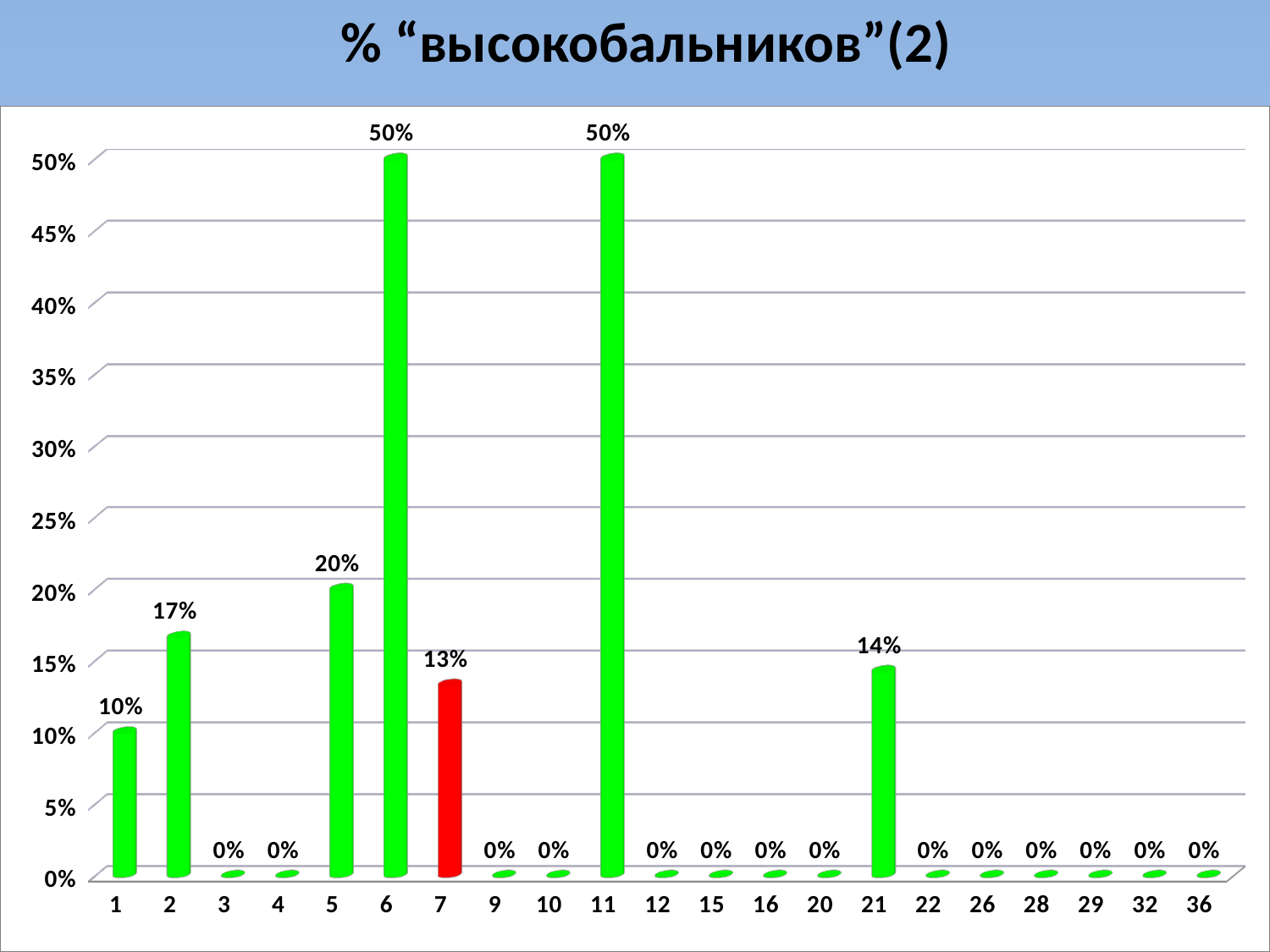
Which category's bar is coloured red instead of green? 7 What is the value for category 5? 20% What is the difference between the values for category 5 and category 1? 10% What is the value for category 2? 17% Which is larger, the value for category 2 or the value for category 21? Category 2 What is the title of the chart? % “высокобальников”(2) What kind of chart is shown on the slide? Bar chart What is the value for category 7? 13% What is the value for category 21? 14% Which two categories share the highest value of 50%? 6 and 11 What is the highest value shown on the chart? 50% How many categories are shown on the x axis? 21